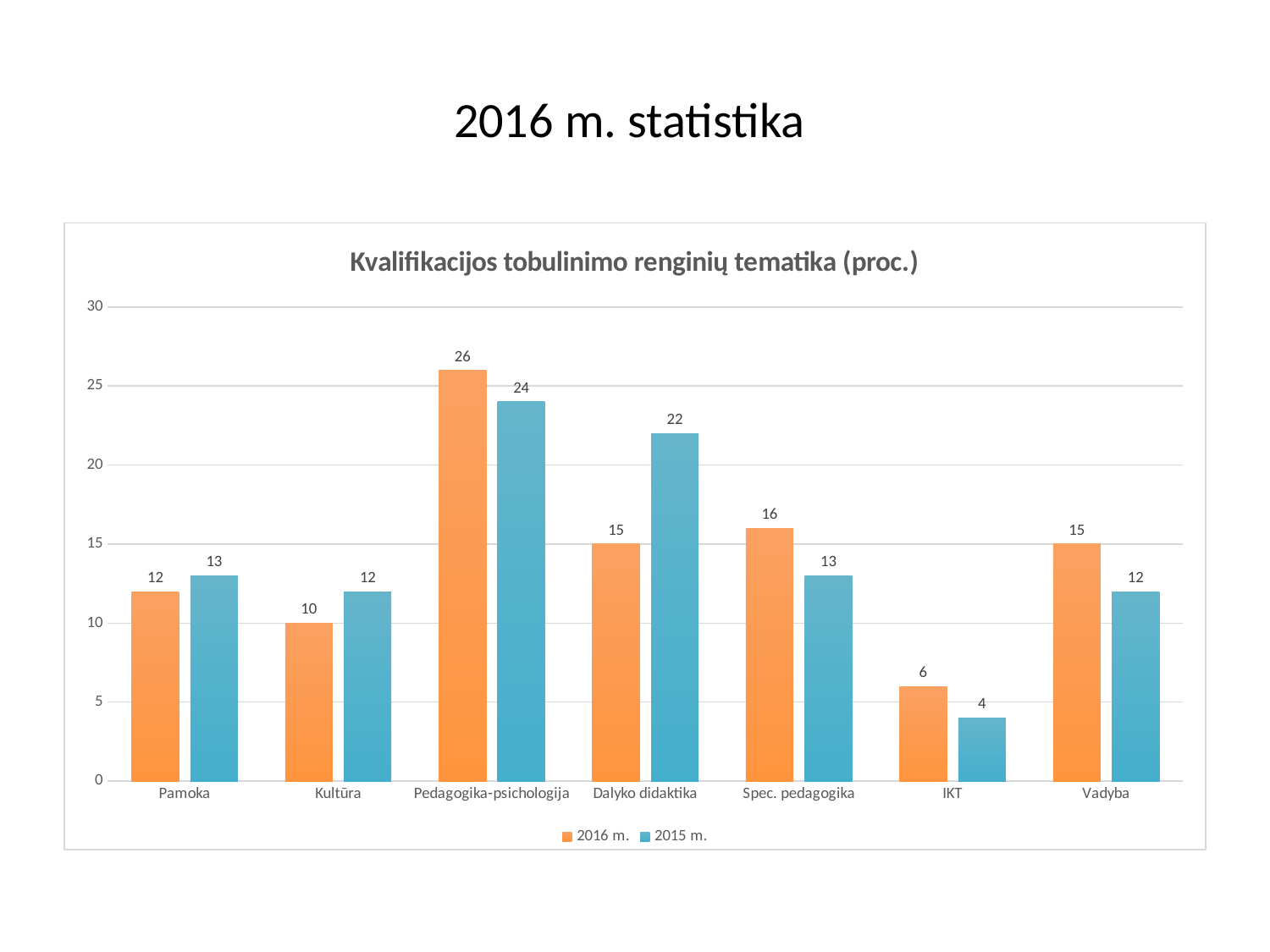
What is the value for IKT in the 2015 m. series? 4 How many categories are shown on the x axis? 7 What is the value for Pedagogika-psichologija in the 2016 m. series? 26 Which is larger for Kultūra: the 2016 m. value or the 2015 m. value? 2015 m. What is the value for Vadyba in the 2016 m. series? 15 What is the title of the chart? Kvalifikacijos tobulinimo renginių tematika (proc.) Is the 2015 m. value for Spec. pedagogika greater or less than 10? greater Which category has the lowest value in the 2016 m. series? IKT How many series does the legend list? 2 What is the difference between the 2016 m. and 2015 m. values for Dalyko didaktika? 7 Which category has the highest value in the 2015 m. series? Pedagogika-psichologija What kind of chart is shown on the slide? Bar chart